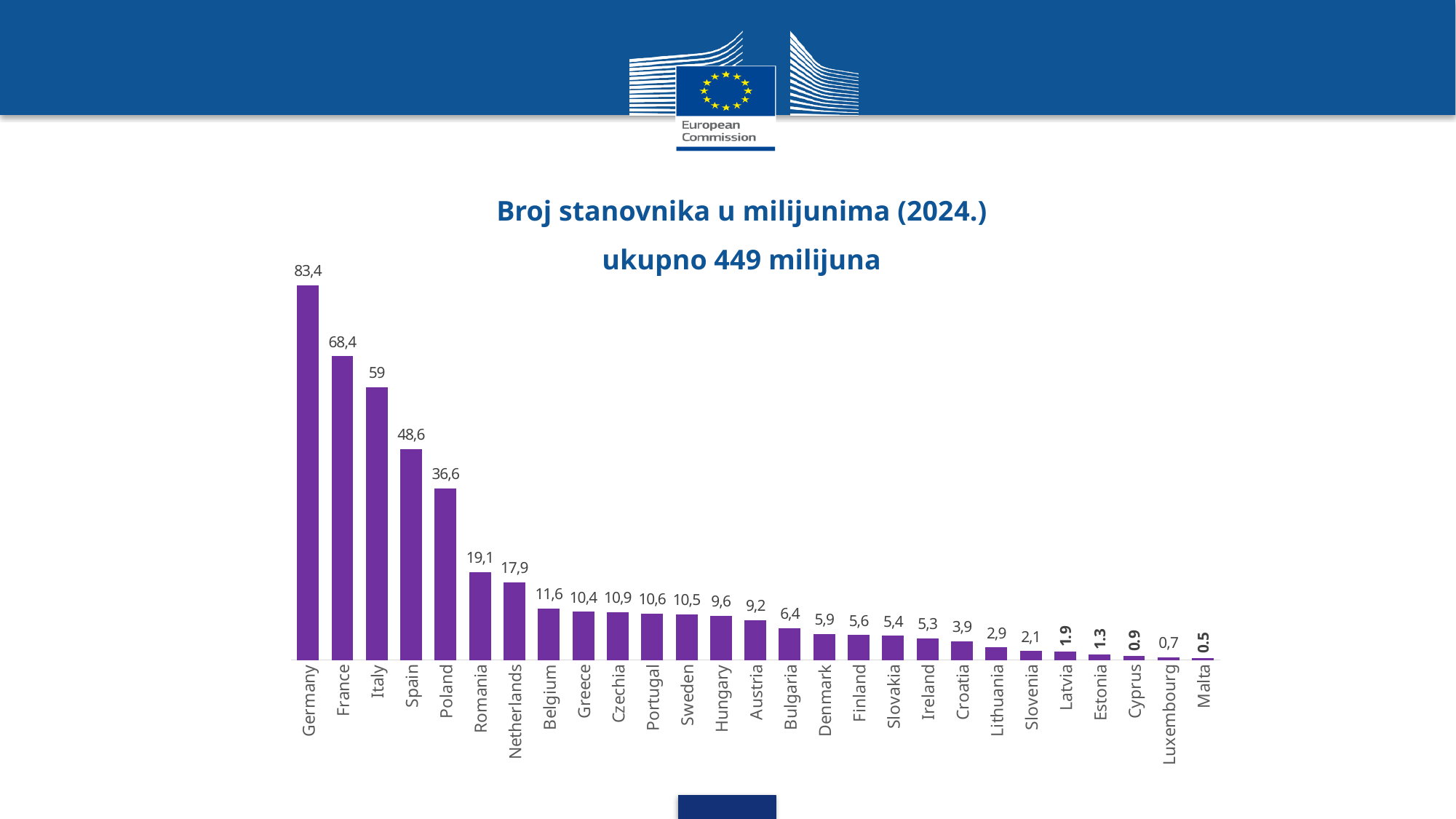
What is the difference between the values for Germany and France? 15 Which country has the lowest value in the chart? Malta What is the value shown for Poland? 36,6 Which has the larger value, Czechia or Greece? Czechia What type of chart is shown on the slide? Bar chart What is the difference between the values for Spain and Poland? 12 What is the value shown for Croatia? 3,9 What is the value shown for Luxembourg? 0,7 How many countries are shown in the chart? 27 What total is stated in the chart title? 449 milijuna What is the value shown for Germany? 83,4 Which country has the highest value in the chart? Germany